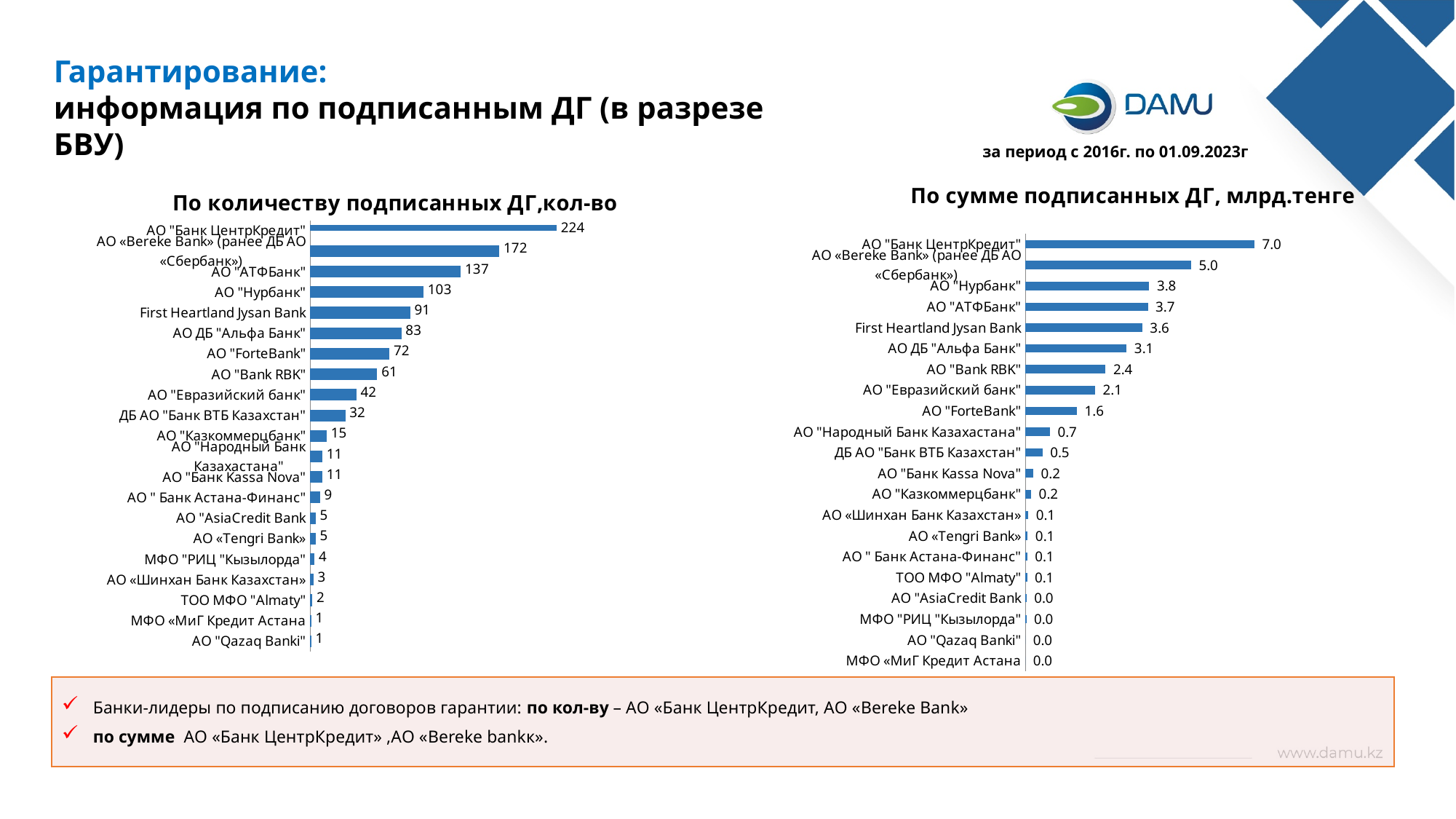
In the chart "По количеству подписанных ДГ,кол-во", what is the difference between АО "Банк ЦентрКредит" and АО «Bereke Bank» (ранее ДБ АО «Сбербанк»)? 52 In the chart "По сумме подписанных ДГ, млрд.тенге", what is the difference between АО "Банк ЦентрКредит" and АО ДБ "Альфа Банк"? 3.9 In the chart "По сумме подписанных ДГ, млрд.тенге", which is larger: АО "ForteBank" or АО "Евразийский банк"? АО "Евразийский банк" What type of chart is the chart "По сумме подписанных ДГ, млрд.тенге"? Bar chart In the chart "По сумме подписанных ДГ, млрд.тенге", what is the value for АО "Народный Банк Казахастана"? 0.7 In the chart "По сумме подписанных ДГ, млрд.тенге", what is the value for АО "Нурбанк"? 3.8 How many banks are listed in the chart "По количеству подписанных ДГ,кол-во"? 21 In the chart "По количеству подписанных ДГ,кол-во", what is the value for АО "ForteBank"? 72 In the chart "По количеству подписанных ДГ,кол-во", which bank has the highest value? АО "Банк ЦентрКредит" In the chart "По количеству подписанных ДГ,кол-во", which is larger: АО "Bank RBK" or АО "Евразийский банк"? АО "Bank RBK" In the chart "По сумме подписанных ДГ, млрд.тенге", which bank has the highest value? АО "Банк ЦентрКредит" In the chart "По количеству подписанных ДГ,кол-во", what is the value for АО "АТФБанк"? 137